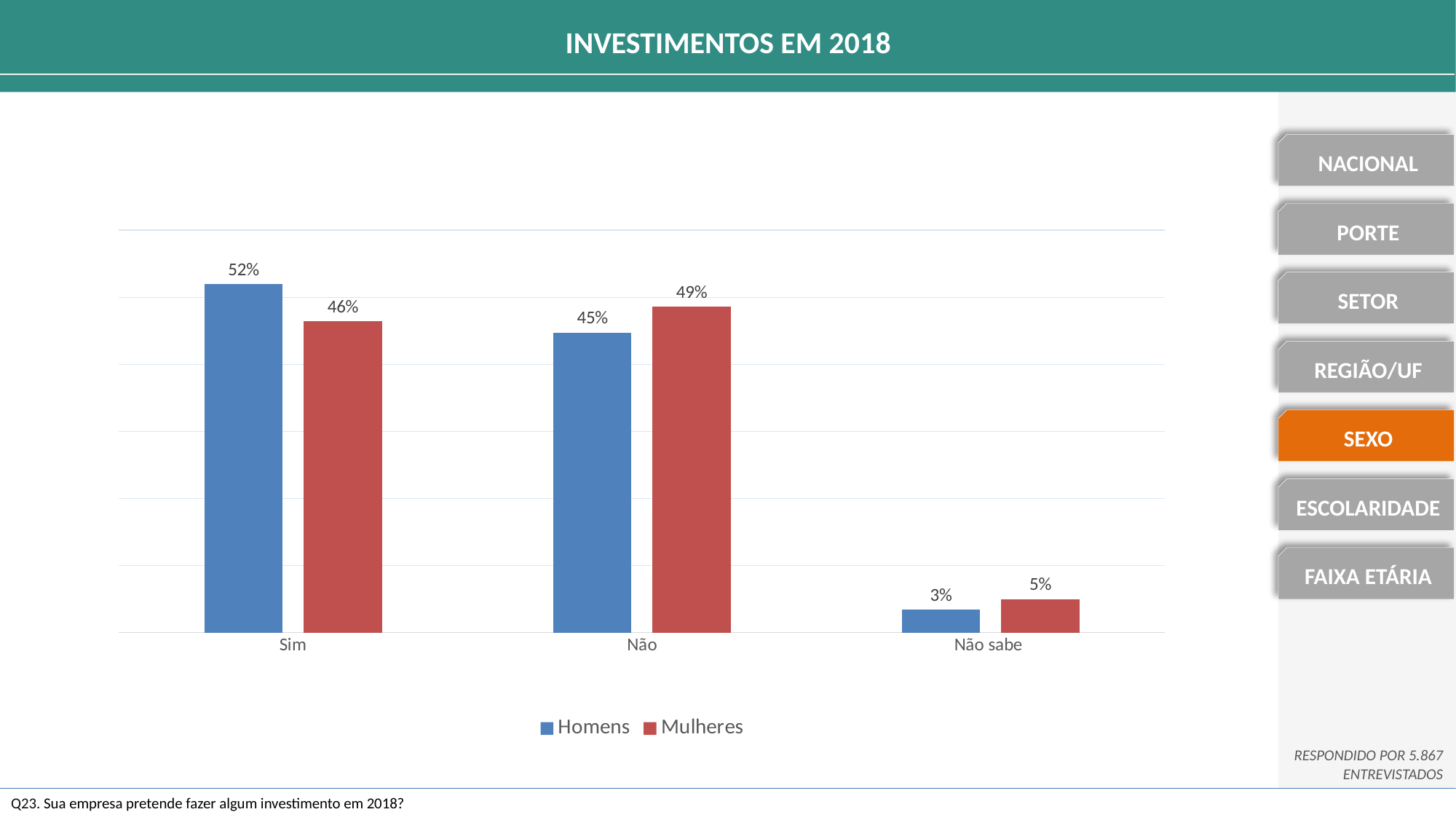
What is the value for Homens in the Sim category? 52% What kind of chart is shown on the slide? Bar chart What is the difference between Homens and Mulheres in the Sim category? 6% Which category has the lowest value for Homens? Não sabe What is the title of the slide? INVESTIMENTOS EM 2018 What is the difference between Mulheres and Homens in the Não category? 4% What is the value for Mulheres in the Não category? 49% Which is larger in the Não sabe category, Homens or Mulheres? Mulheres What is the value for Mulheres in the Não sabe category? 5% How many categories are shown on the x axis? 3 How many series does the legend list? 2 Which category has the highest value for Mulheres? Não